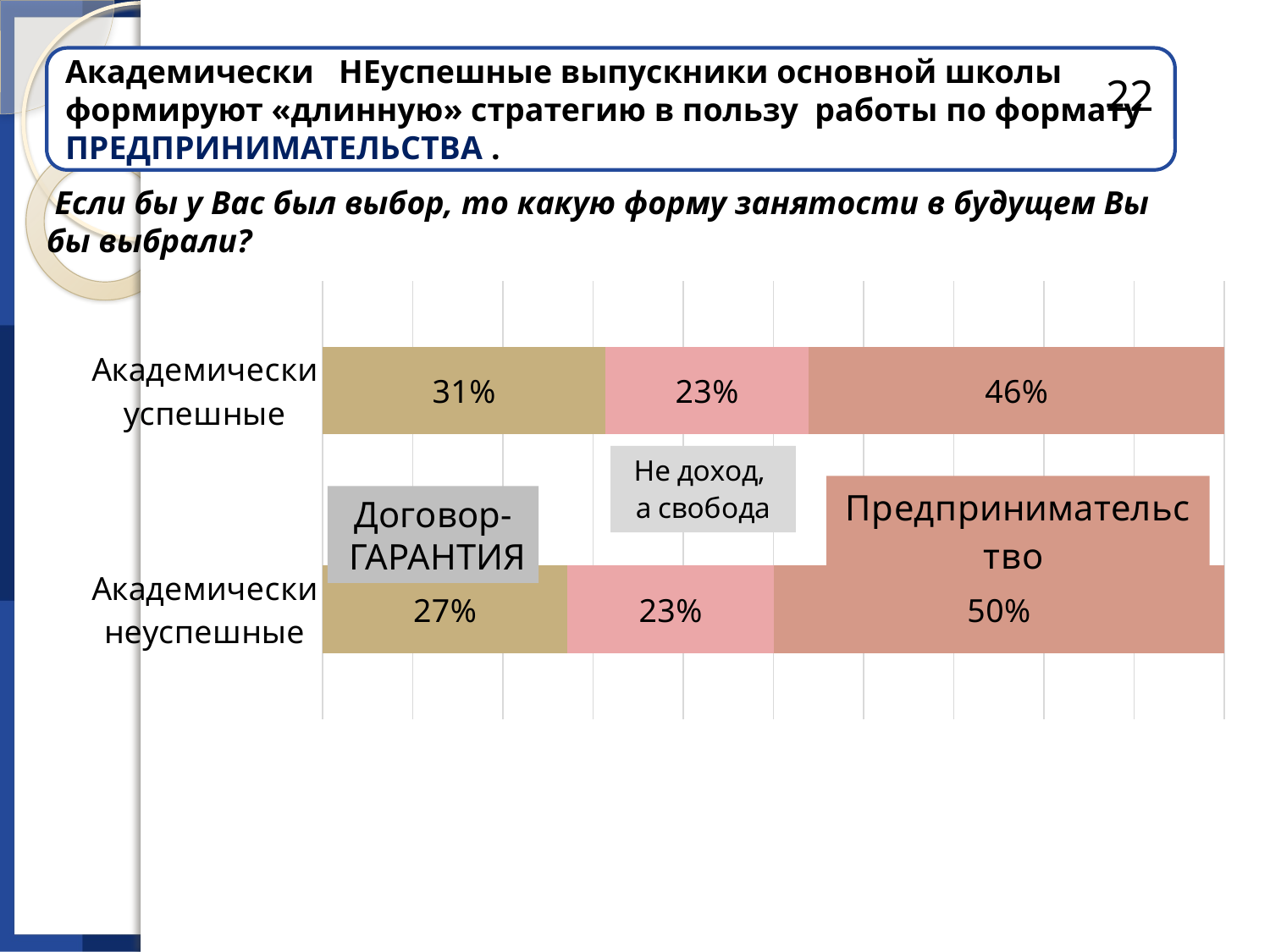
What percentage of academically unsuccessful graduates (Академически неуспешные) chose Предпринимательство? 50% What percentage of academically successful graduates (Академически успешные) chose Договор-ГАРАНТИЯ? 31% What percentage of academically successful graduates (Академически успешные) chose Предпринимательство? 46% Which group has a larger share choosing Договор-ГАРАНТИЯ: Академически успешные or Академически неуспешные? Академически успешные What is the difference between the Предпринимательство shares of academically unsuccessful and academically successful graduates? 4 percentage points Which employment option has the smallest share among academically successful graduates (Академически успешные)? Не доход, а свобода What type of chart is shown on the slide? Stacked bar chart What percentage of academically unsuccessful graduates (Академически неуспешные) chose Договор-ГАРАНТИЯ? 27% How many groups (categories) are shown in the chart? 2 What is the total of the three segments in the bar for Академически успешные? 100% What percentage of academically unsuccessful graduates (Академически неуспешные) chose Не доход, а свобода? 23% Which employment option has the largest share among academically unsuccessful graduates (Академически неуспешные)? Предпринимательство